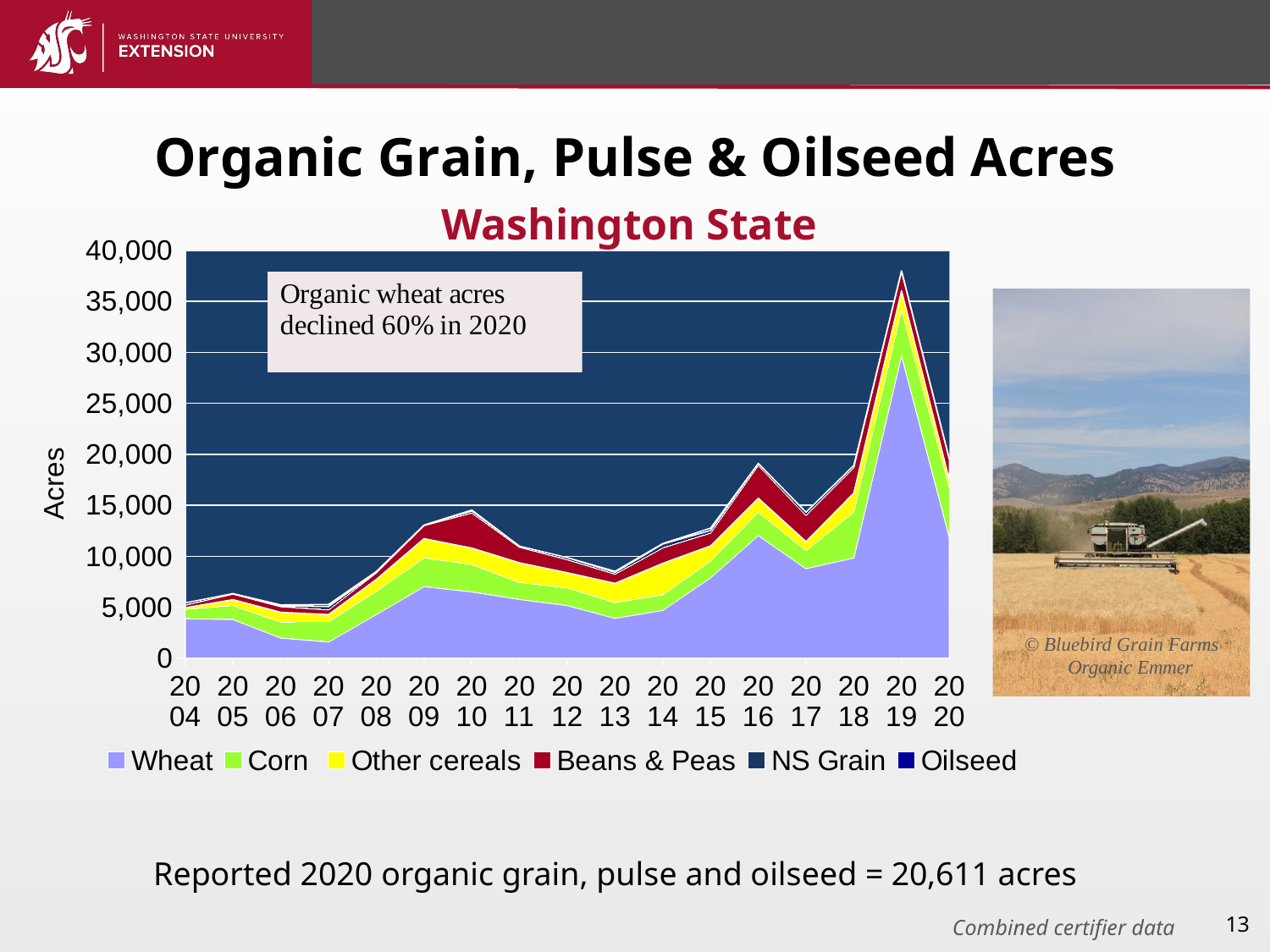
Is the Wheat acreage in 2019 greater or less than 25,000? greater Is the total organic acreage in 2013 greater or less than 10,000? less Is the Wheat acreage in 2004 greater or less than 5,000? less What is the label on the y axis of the chart? Acres What kind of chart is shown on the slide? Stacked area chart How many years are shown along the x axis of the chart? 17 How many series does the chart legend list? 6 According to the text on the slide, what was the reported 2020 organic grain, pulse and oilseed acreage? 20,611 acres Which year has the larger total organic acreage, 2019 or 2020? 2019 In which year does the total organic acreage reach its highest point? 2019 Does the total organic acreage rise or fall from 2019 to 2020? fall